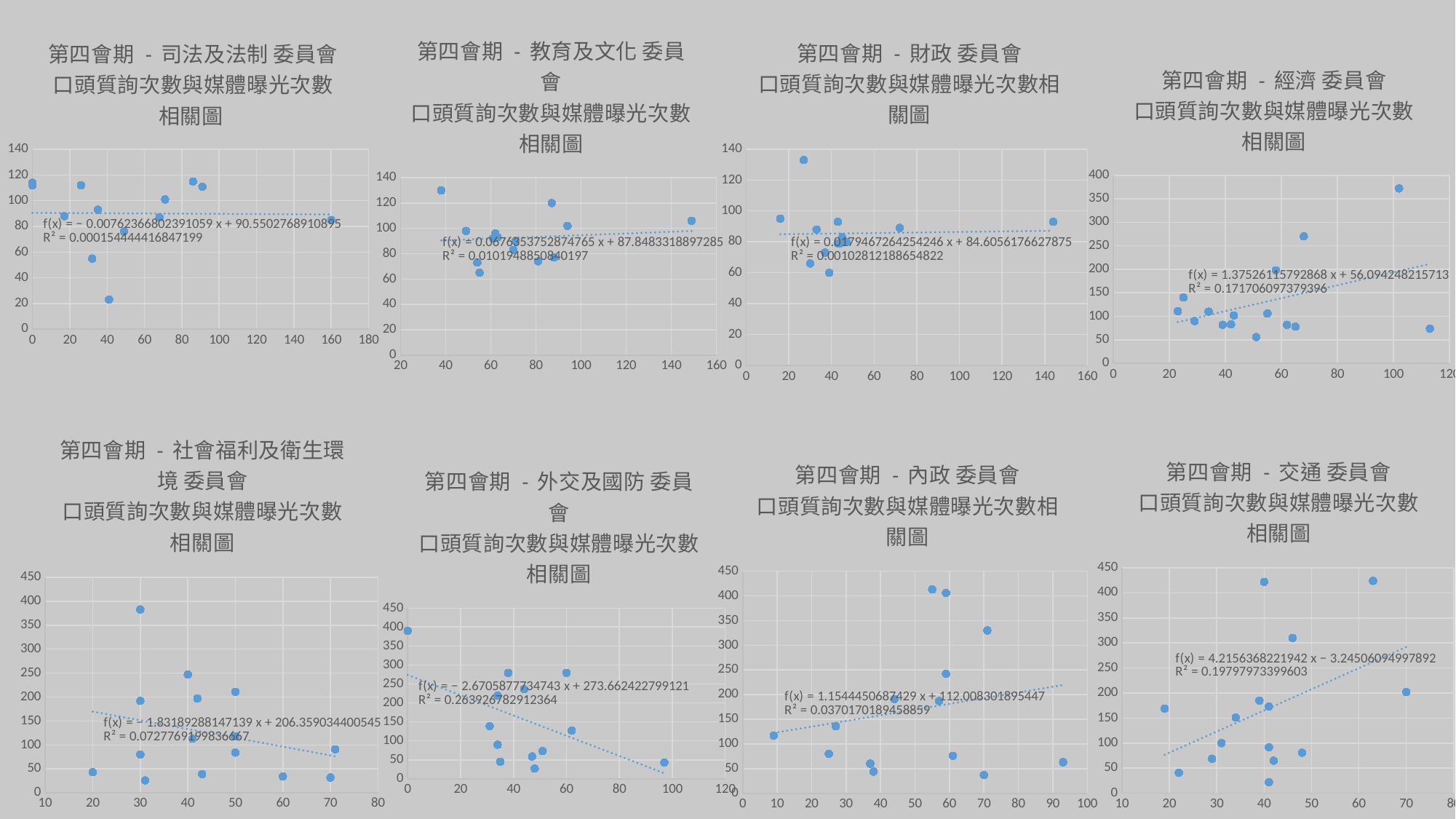
In the 第四會期 - 交通 委員會 chart, does the dotted trendline rise or fall as x increases? rise Which of the eight charts shows the lowest R² value? 第四會期 - 司法及法制 委員會 In the 第四會期 - 外交及國防 委員會 chart, does the dotted trendline rise or fall as x increases? fall In the 第四會期 - 外交及國防 委員會 chart, what is the R² value printed on the chart? R² = 0.263926782912364 Is the R² value in the 第四會期 - 經濟 委員會 chart larger or smaller than the R² value in the 第四會期 - 內政 委員會 chart? larger Which of the eight charts shows the highest R² value? 第四會期 - 外交及國防 委員會 What kind of chart is the 第四會期 - 交通 委員會 chart at the bottom right of the slide? scatter chart In the 第四會期 - 交通 委員會 chart, what is the trendline equation printed on the chart? f(x) = 4.2156368221942 x − 3.24506094997892 In the 第四會期 - 經濟 委員會 chart, is the highest plotted point greater or less than 300 on the y axis? greater How many charts are shown on the slide? 8 In the 第四會期 - 司法及法制 委員會 chart, what is the R² value printed on the chart? R² = 0.000154444416847199 In the 第四會期 - 司法及法制 委員會 chart, is the lowest plotted point greater or less than 40 on the y axis? less